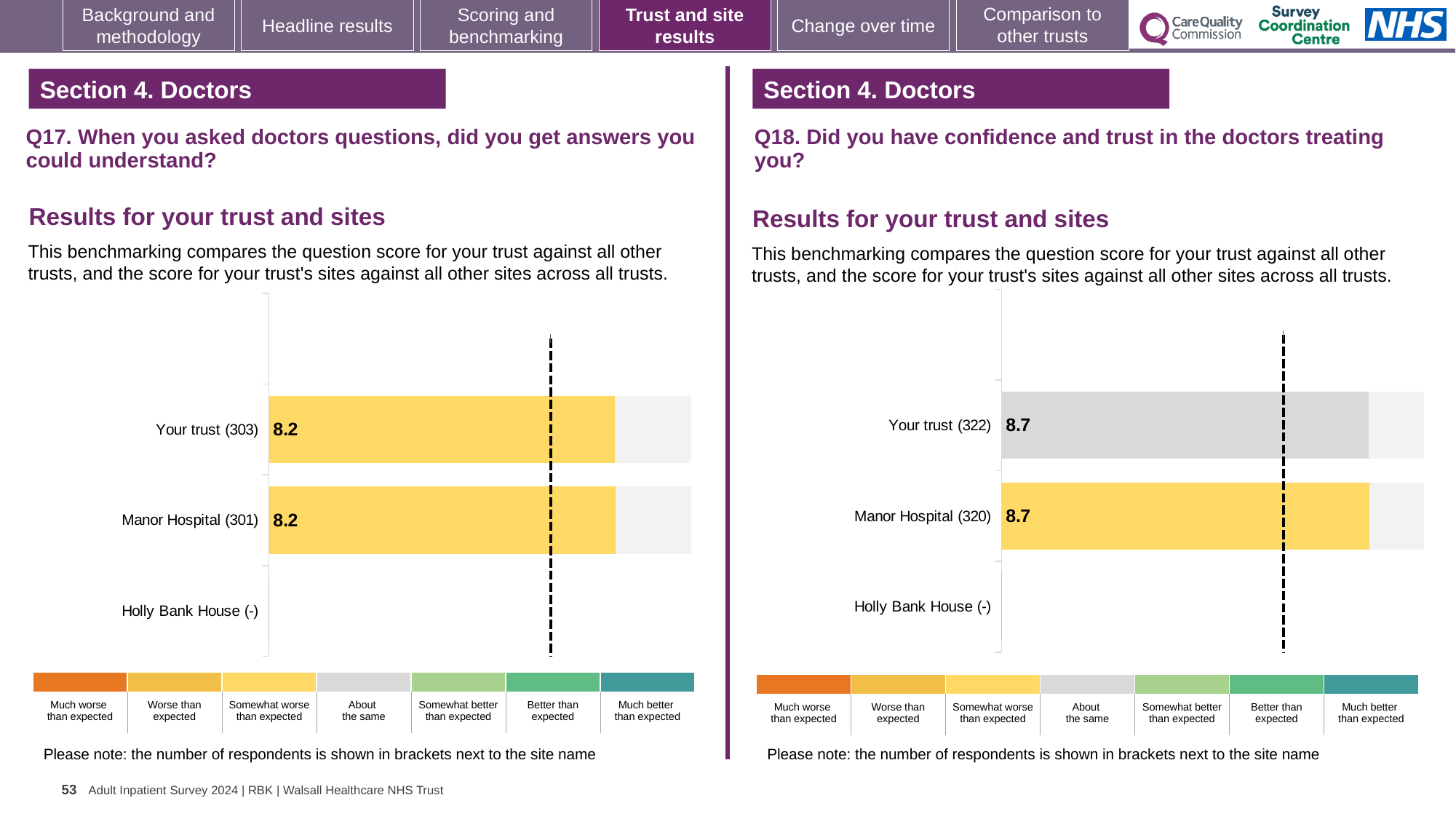
How many site/trust categories are listed on the Q18 chart? 3 On the Q18 chart, which benchmark category does the colour of the Your trust bar indicate? About the same On the Q18 chart, which category has no score shown? Holly Bank House On the Q17 chart, what is the score for Your trust? 8.2 On the Q18 chart, what is the score for Manor Hospital? 8.7 On the Q17 chart, how many respondents are shown for Manor Hospital? 301 What kind of chart is used on the Q17 slide? Bar chart On the Q17 chart, which benchmark category does the colour of the Manor Hospital bar indicate? Somewhat worse than expected On the Q18 chart, how many respondents are shown for Your trust? 322 On the Q18 chart, what is the score for Your trust? 8.7 On the Q17 chart, what is the difference between the scores for Your trust and Manor Hospital? 0 On the Q17 chart, what is the score for Manor Hospital? 8.2